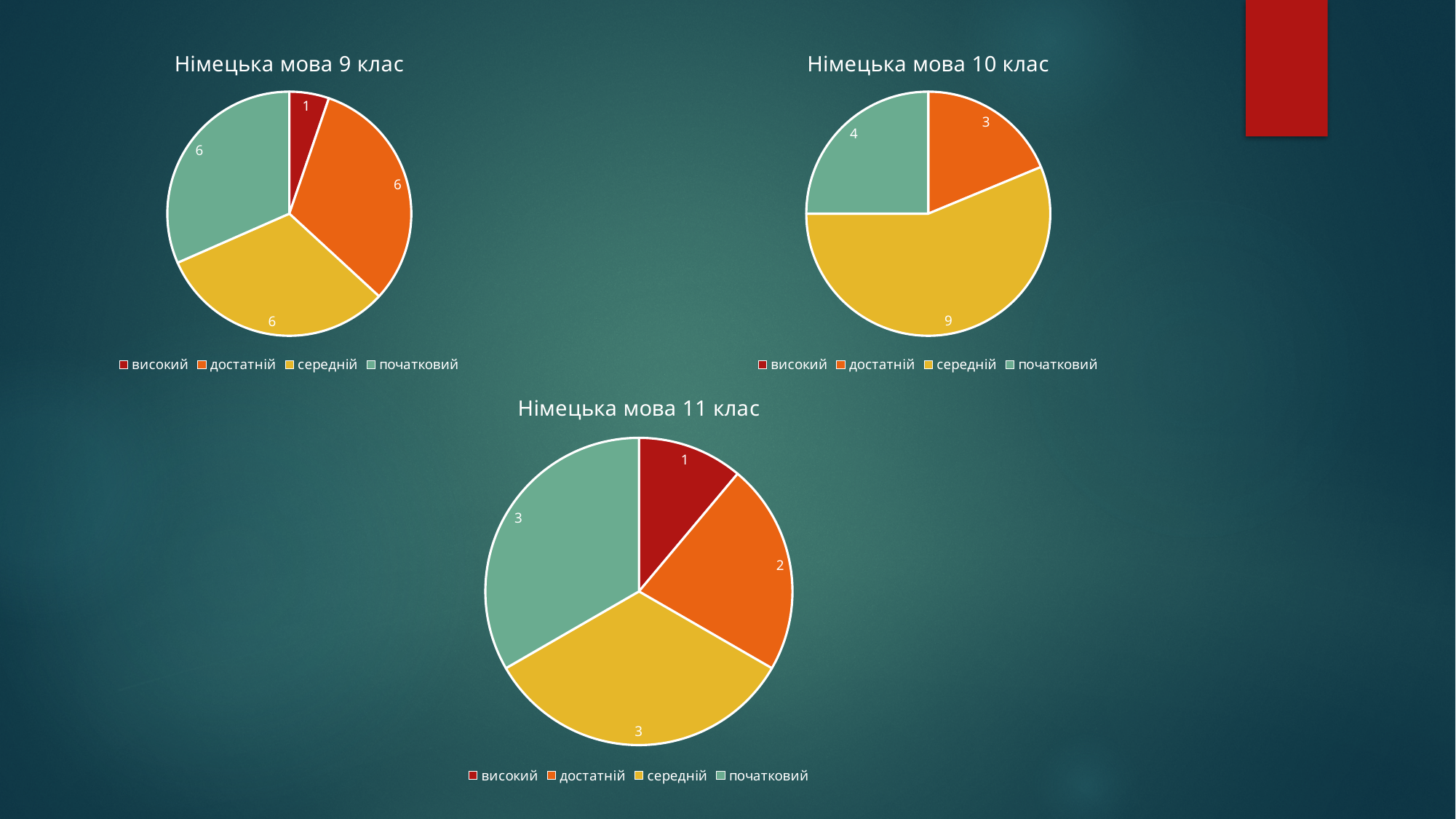
In the chart titled "Німецька мова 11 клас", which category has the smallest slice? високий How many slices are shown in the chart titled "Німецька мова 10 клас"? 3 In the chart titled "Німецька мова 10 клас", what share of the pie does середній represent? 56.25% In the chart titled "Німецька мова 11 клас", which is larger, the value for середній or the value for достатній? середній In the chart titled "Німецька мова 10 клас", what is the difference between the values for середній and початковий? 5 In the chart titled "Німецька мова 11 клас", what is the value for достатній? 2 In the chart titled "Німецька мова 10 клас", what is the value for середній? 9 In the chart titled "Німецька мова 10 клас", which category has the largest slice? середній In the chart titled "Німецька мова 9 клас", what is the total of all the slice values? 19 What type of chart is "Німецька мова 11 клас"? pie chart How many entries does the legend of the chart titled "Німецька мова 9 клас" list? 4 In the chart titled "Німецька мова 9 клас", what is the value for високий? 1